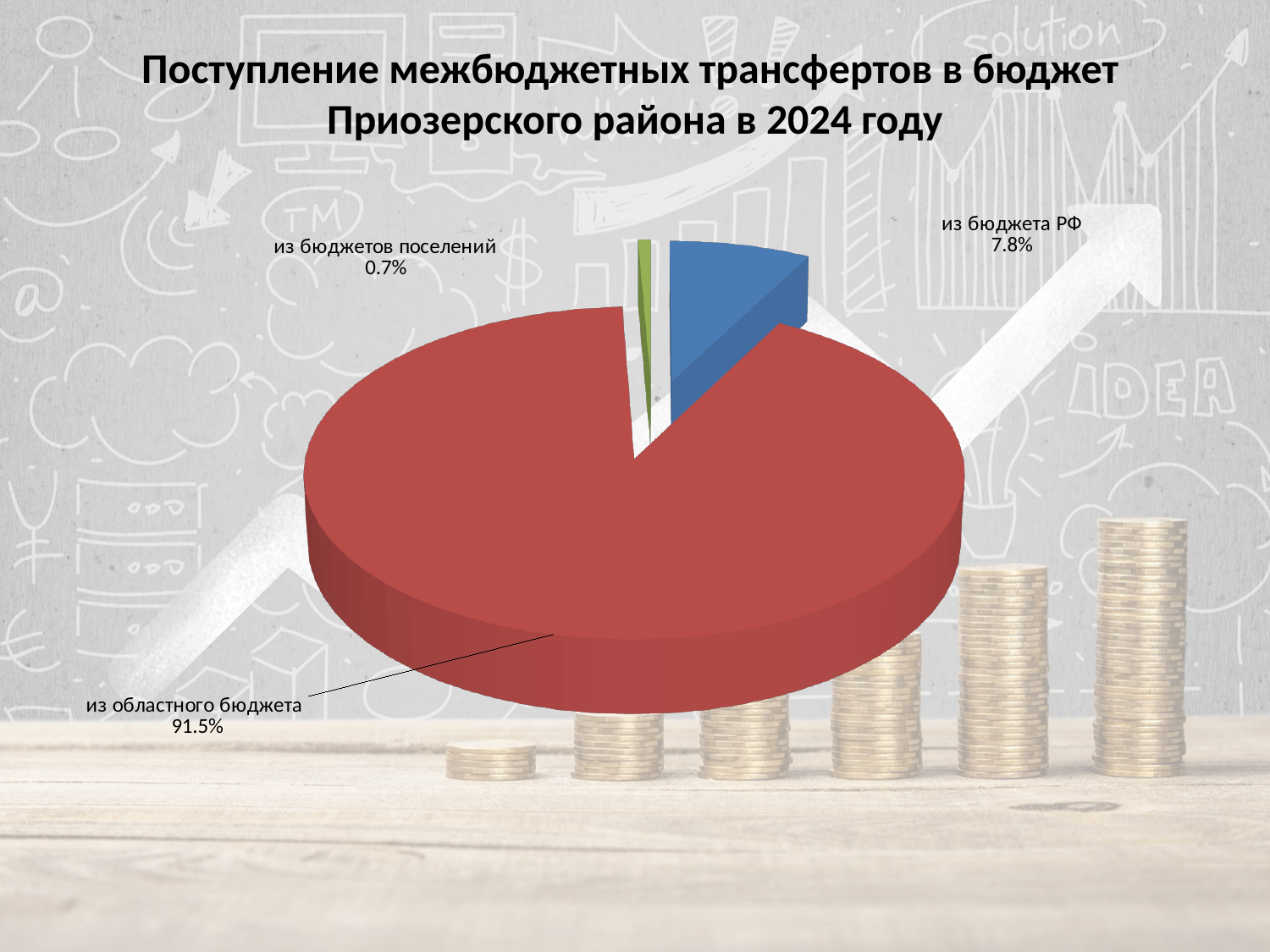
What share of the pie is 'из областного бюджета'? 91.5% How many slices does the pie chart have? 3 What kind of chart is shown on the slide? pie chart What share of the pie is 'из бюджета РФ'? 7.8% What colour is the slice for 'из бюджета РФ'? blue Which slice of the pie is the largest? из областного бюджета What is the difference between the shares for 'из бюджета РФ' and 'из бюджетов поселений'? 7.1% What share of the pie is 'из бюджетов поселений'? 0.7% Which is larger: the share for 'из бюджета РФ' or for 'из бюджетов поселений'? из бюджета РФ What is the title of the chart on the slide? Поступление межбюджетных трансфертов в бюджет Приозерского района в 2024 году Which slice of the pie is the smallest? из бюджетов поселений What is the difference between the shares for 'из областного бюджета' and 'из бюджета РФ'? 83.7%